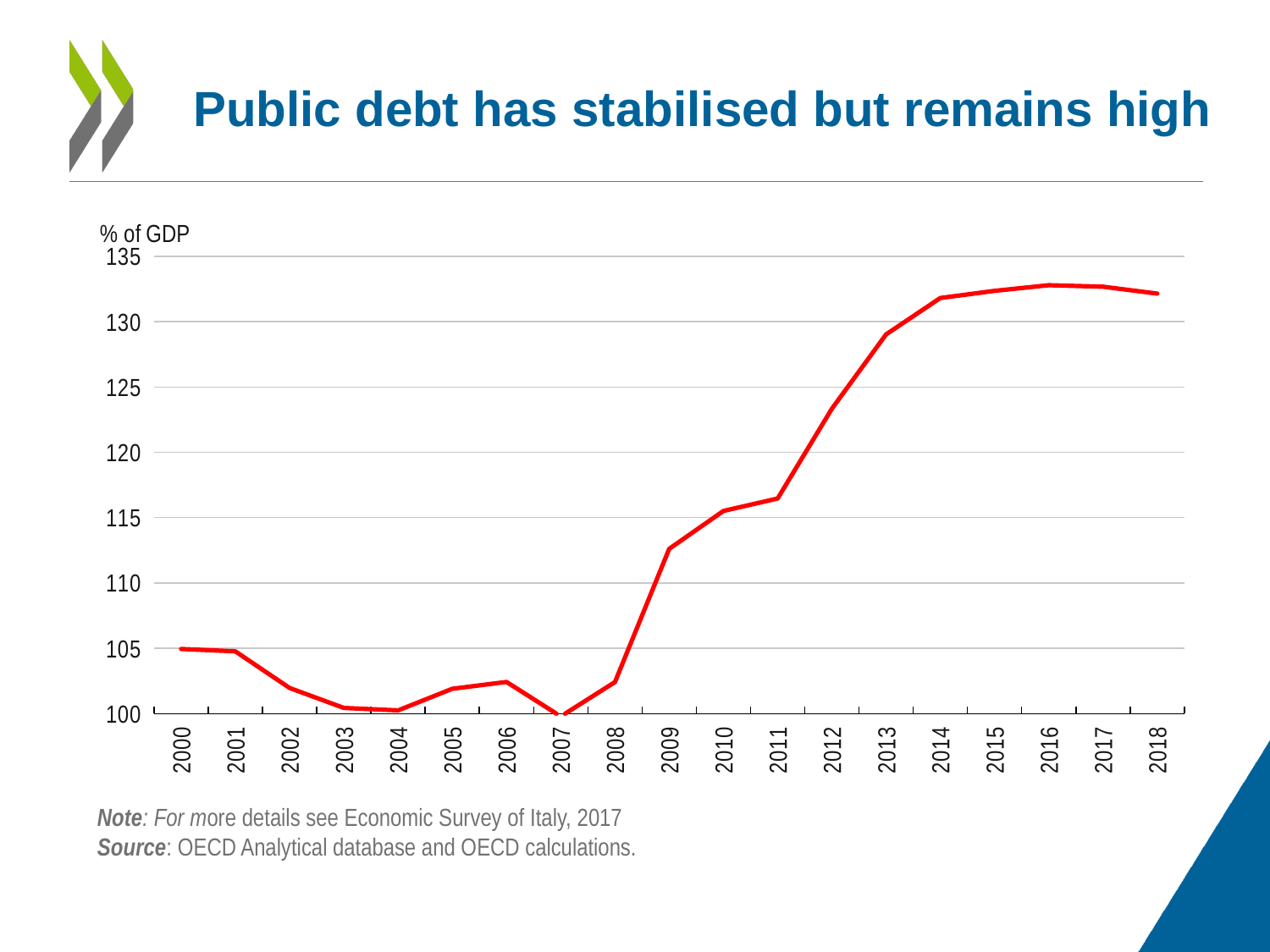
In which year is public debt as a % of GDP at its highest? 2016 How many years are plotted along the x axis of the chart? 19 Does public debt as a % of GDP rise or fall between 2007 and 2014? rise In which year is public debt as a % of GDP at its lowest? 2007 Which year has the higher public debt as a % of GDP, 2000 or 2018? 2018 What is the title of the chart on the slide? Public debt has stabilised but remains high Is the value for 2012 greater or less than 120? greater What kind of chart is shown on the slide? line chart Is the value for 2014 greater or less than 130? greater Is the value for 2009 greater or less than 110? greater What unit is the vertical axis of the chart measured in? % of GDP